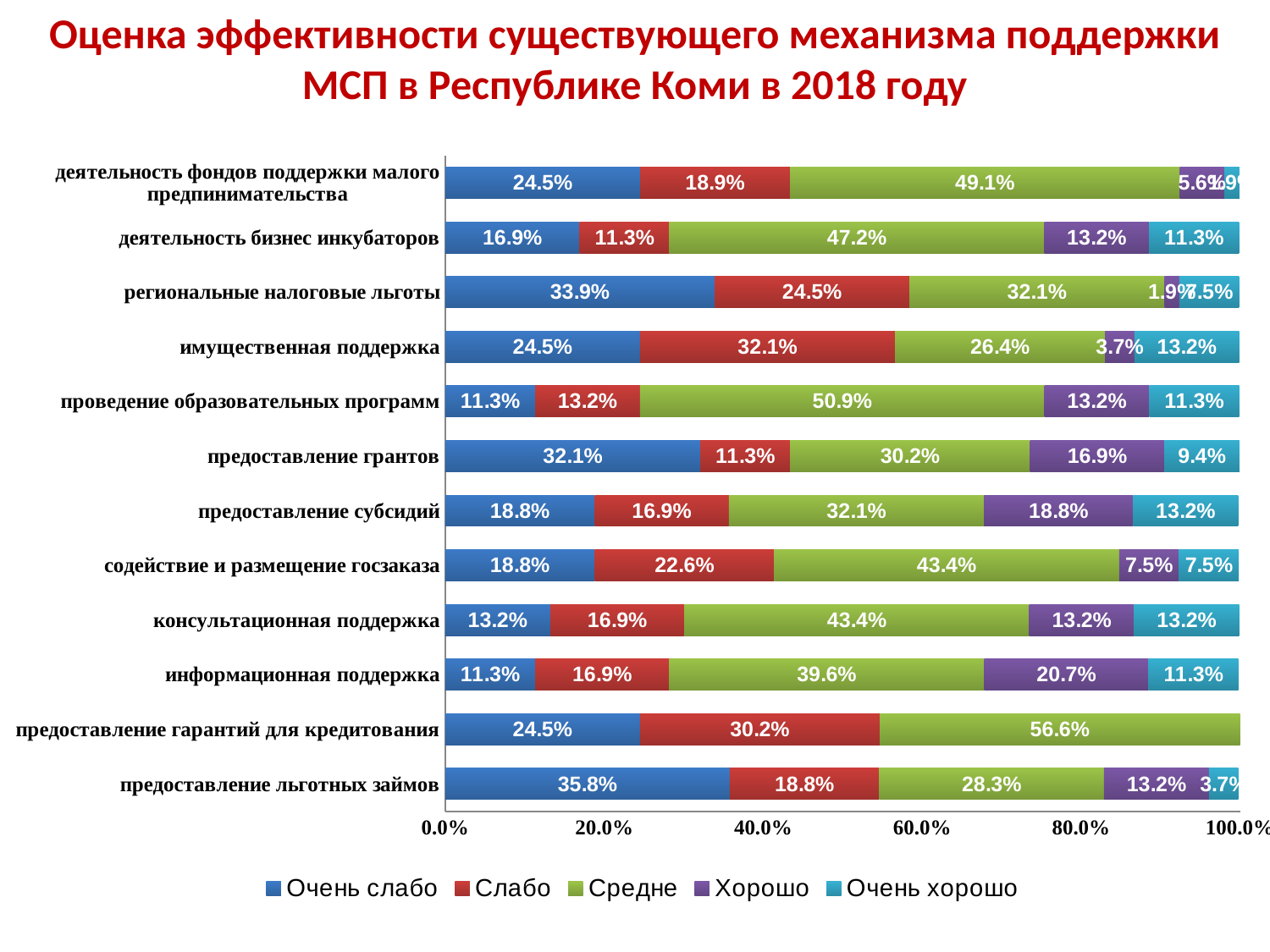
What is the 'Хорошо' value for 'информационная поддержка'? 20.7% How many categories (support measures) are plotted on the chart? 12 Which category has the highest 'Очень слабо' value? предоставление льготных займов Which legend entry is shown in green? Средне What is the 'Очень хорошо' value for 'деятельность бизнес инкубаторов'? 11.3% What kind of chart is shown on the slide? Stacked bar chart What is the 'Очень слабо' value for 'предоставление льготных займов'? 35.8% What is the difference between the 'Очень слабо' and 'Слабо' values for 'предоставление грантов'? 20.8% For 'имущественная поддержка', which is larger: the 'Слабо' value or the 'Средне' value? Слабо Which category has the highest 'Средне' value? предоставление гарантий для кредитования What is the 'Средне' value for 'предоставление гарантий для кредитования'? 56.6% How many series does the legend list? 5